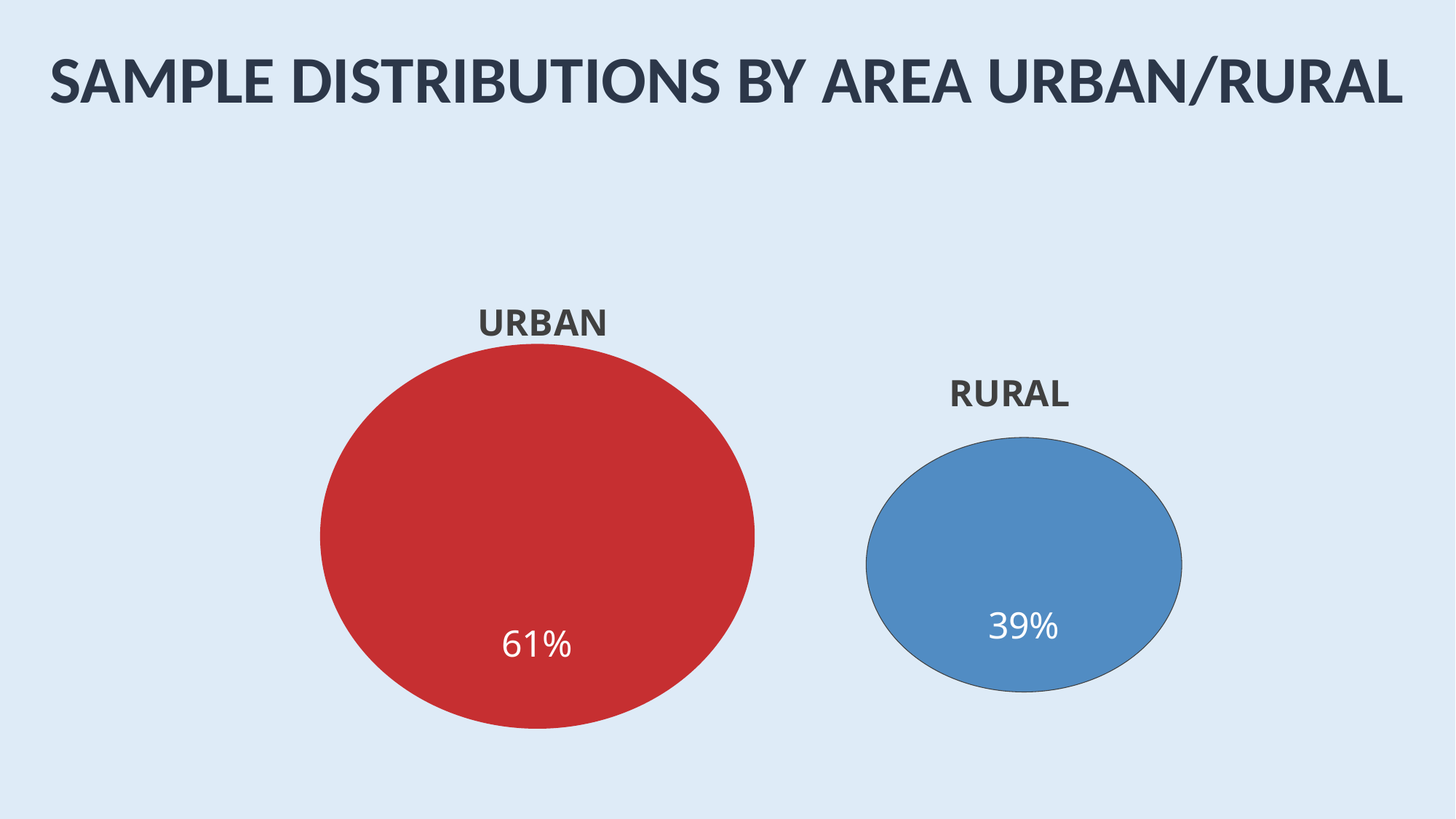
What do the Urban and Rural shares add up to? 100% By how many percentage points does the Urban share exceed the Rural share? 22 percentage points Is the Urban share larger or smaller than the Rural share? larger What percentage of the sample is Urban? 61% Is the Urban share greater or less than 50%? greater How many area categories are shown on the chart? 2 What percentage of the sample is Rural? 39% Which area has the larger share of the sample? Urban Is the Rural share greater or less than 50%? less What is the title of the slide? SAMPLE DISTRIBUTIONS BY AREA URBAN/RURAL Which area has the smaller share of the sample? Rural What colour is the Urban circle? Red